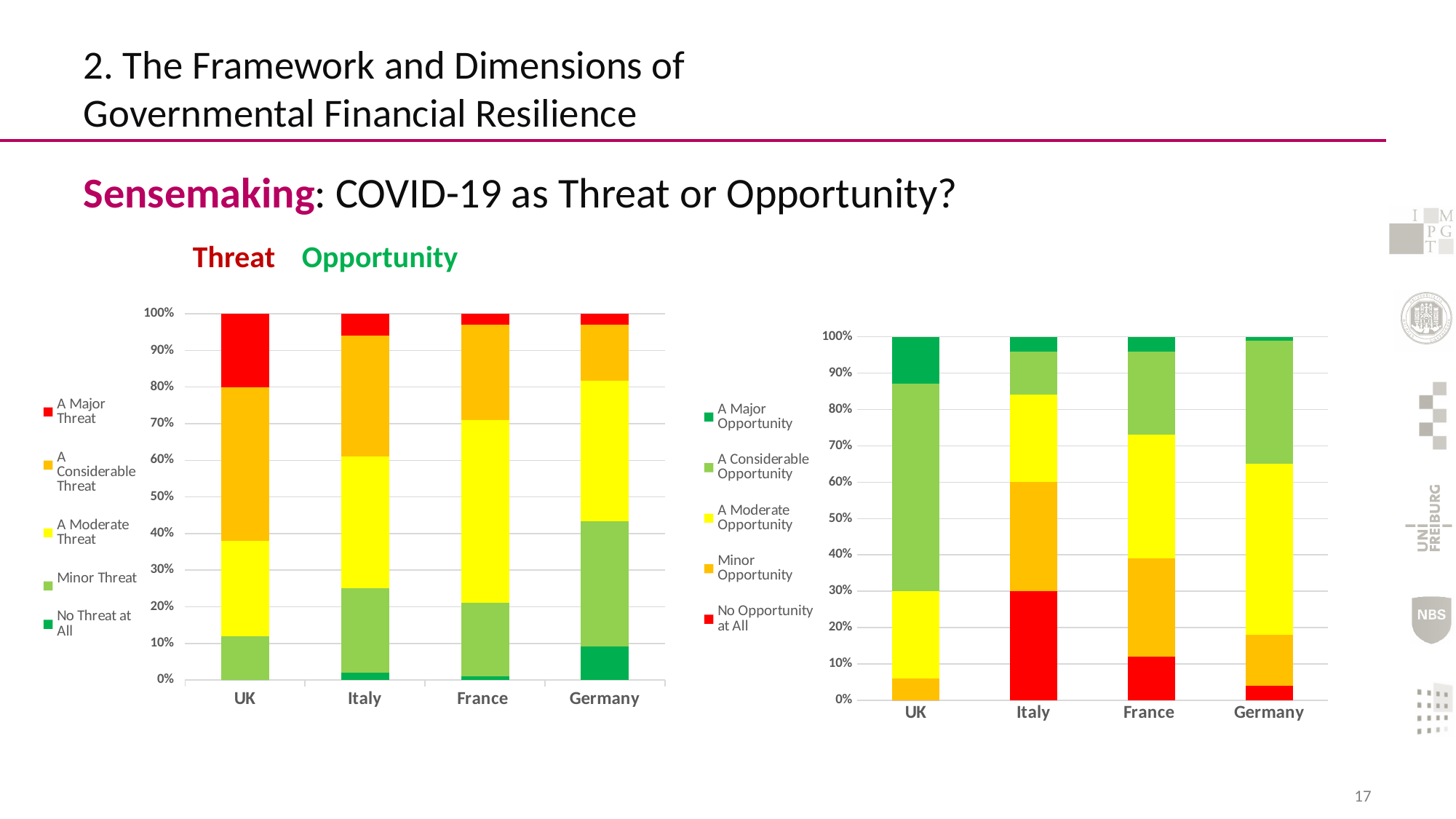
In the Threat chart on the left, is the 'A Major Threat' share for the UK greater or less than 10%? greater What kind of chart is the Threat chart on the left? Stacked bar chart How many series does the legend of the Opportunity chart on the right list? 5 In the Threat chart on the left, which country has the larger 'A Moderate Threat' segment, France or UK? France In the Opportunity chart on the right, which country has the largest 'No Opportunity at All' segment? Italy In the Opportunity chart on the right, is the 'No Opportunity at All' share for Italy greater or less than 20%? greater In the Threat chart on the left, which country has the smallest 'A Considerable Threat' segment? Germany In the Threat chart on the left, which country has the largest 'A Major Threat' segment? UK In the Opportunity chart on the right, what colour represents 'A Major Opportunity' in the legend? Green In the Threat chart on the left, which country has the largest 'No Threat at All' segment? Germany How many countries are shown on the x axis of the Opportunity chart on the right? 4 In the Opportunity chart on the right, which country has the larger 'A Considerable Opportunity' segment, UK or Italy? UK